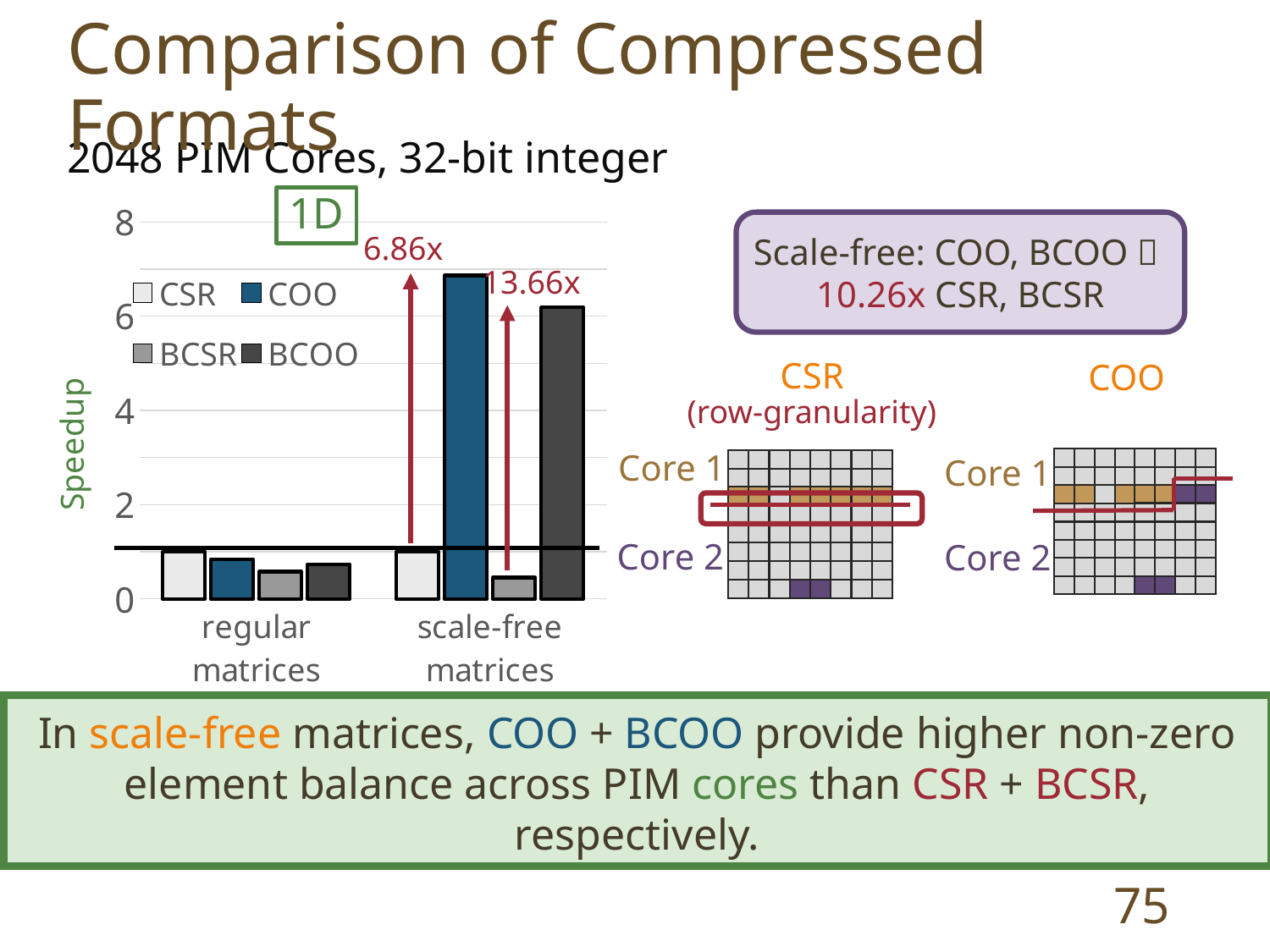
Is the speedup of BCOO for scale-free matrices greater or less than 4? greater Is the speedup of BCSR for scale-free matrices greater or less than 2? less What is the label of the y axis of the chart? Speedup What kind of chart is shown on the slide? bar chart What are the four series listed in the chart legend? CSR, COO, BCSR, BCOO How many series does the chart legend list? 4 How many categories are shown on the x axis of the chart? 2 Which series has the highest speedup for scale-free matrices? COO For scale-free matrices, which has the larger speedup, COO or BCOO? COO For regular matrices, which has the larger speedup, CSR or COO? CSR Is the speedup of COO for scale-free matrices greater or less than 6? greater Which series has the lowest speedup for scale-free matrices? BCSR